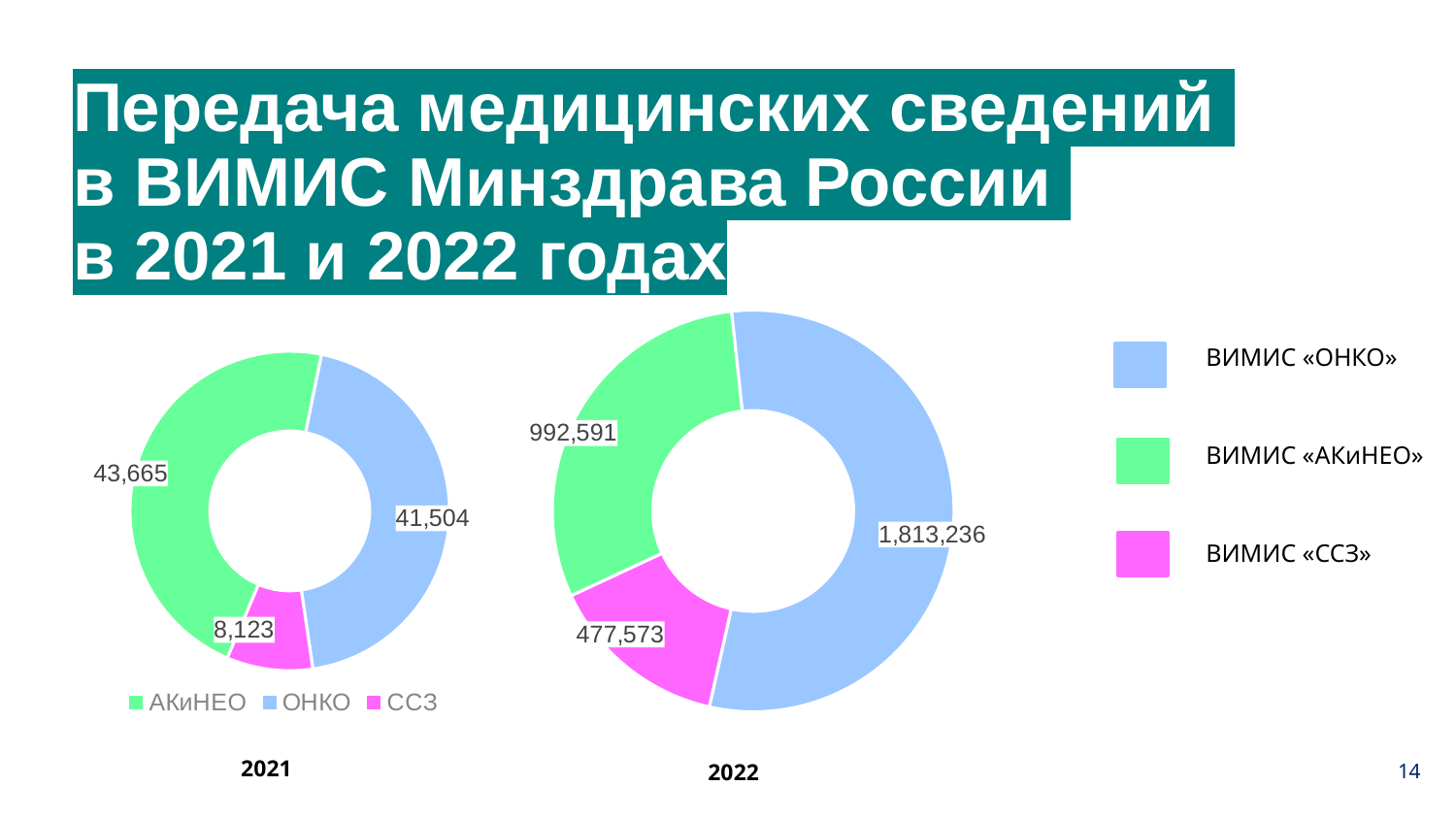
In the 2021 chart, what is the difference between the АКиНЕО and ОНКО values? 2,161 In the 2021 chart, what is the value for ОНКО? 41,504 In the 2021 chart, which category has the largest value? АКиНЕО How many categories does the 2021 chart show? 3 In the 2022 chart, what is the value for АКиНЕО? 992,591 In the 2022 chart, what is the value for ОНКО? 1,813,236 What colour represents ВИМИС «ССЗ» in the legend on the right? Pink (magenta) What kind of chart is the 2022 chart? Doughnut (pie) chart In the 2022 chart, what is the difference between the ОНКО and АКиНЕО values? 820,645 In the 2021 chart, what is the value for ССЗ? 8,123 In the 2022 chart, which is larger, the value for ССЗ or the value for АКиНЕО? АКиНЕО In the 2022 chart, which category has the smallest value? ССЗ